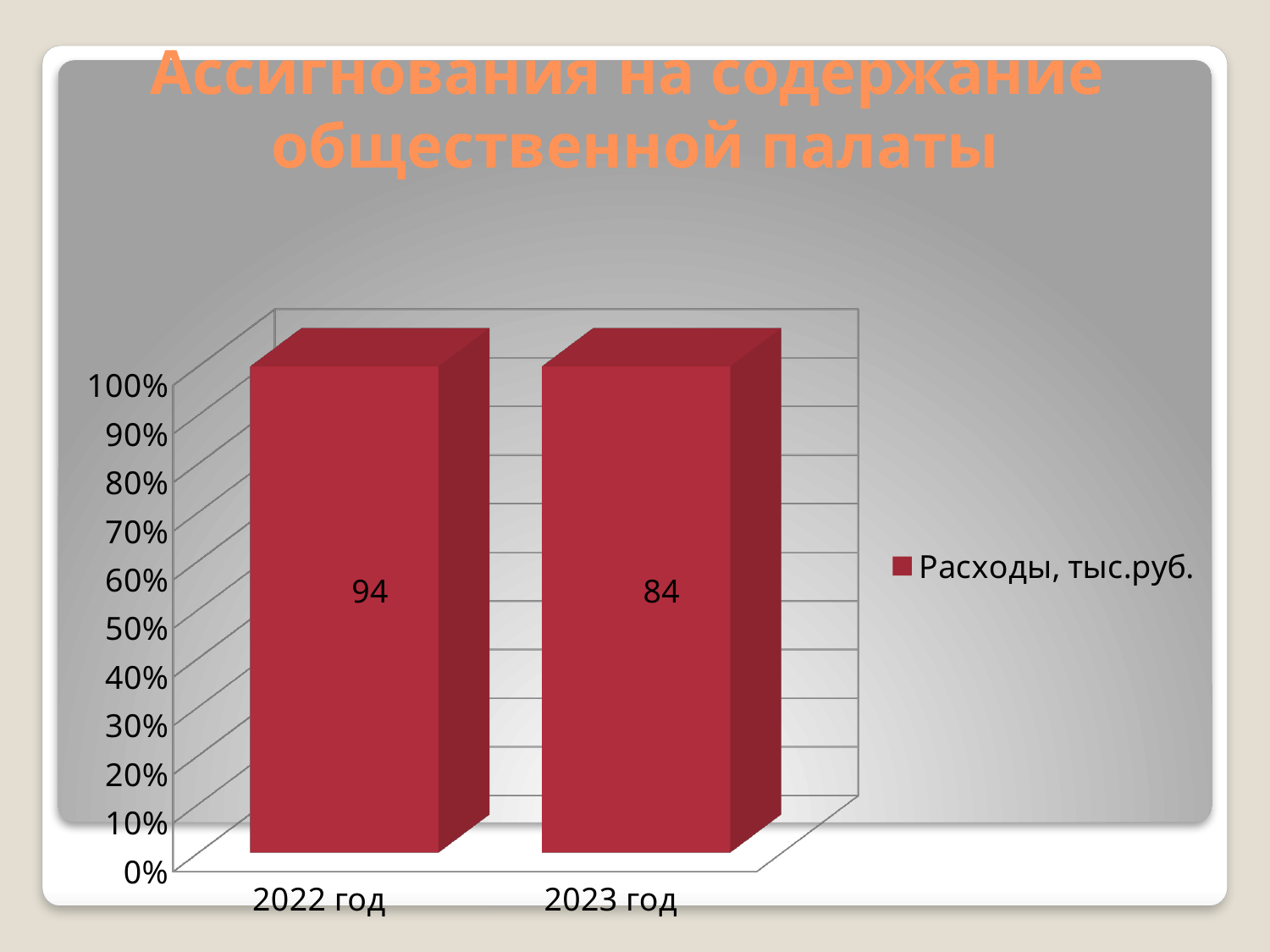
What is the title of the chart? Ассигнования на содержание общественной палаты What is the name of the series shown in the legend? Расходы, тыс.руб. What is the difference between the labelled values for 2022 год and 2023 год? 10 Is the labelled value for 2023 год larger or smaller than the value for 2022 год? smaller How many series does the legend list? 1 How many categories are shown on the x axis of the chart? 2 Do the labelled values rise or fall from 2022 год to 2023 год? fall What is the value of the data label on the bar for 2023 год? 84 Which year has the higher labelled value, 2022 год or 2023 год? 2022 год Which year has the lower labelled value? 2023 год What kind of chart is shown on the slide? bar chart What is the value of the data label on the bar for 2022 год? 94